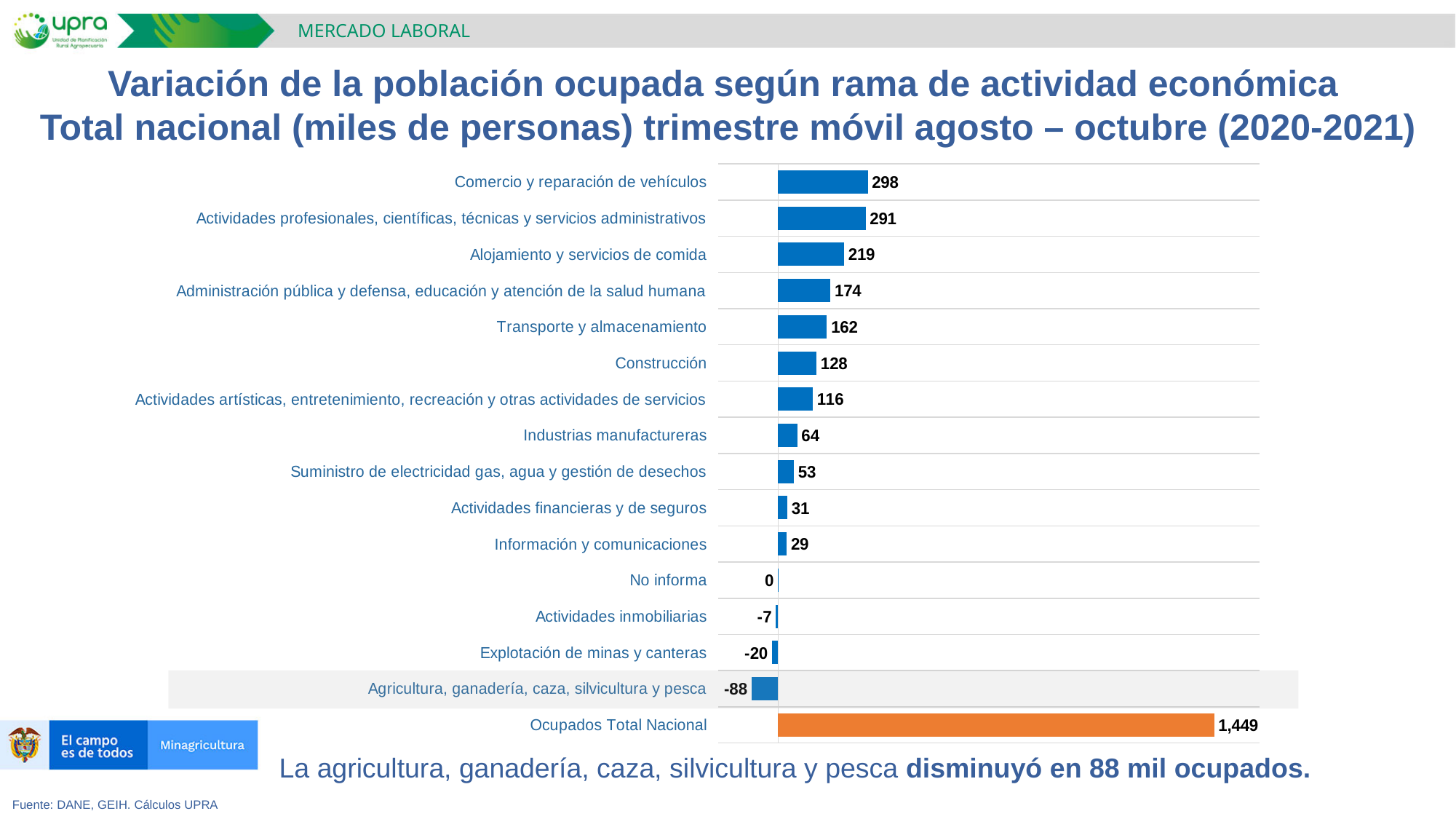
Which category has the lowest value? Agricultura, ganadería, caza, silvicultura y pesca What is the value for Explotación de minas y canteras? -20 What is the difference between the values for Alojamiento y servicios de comida and Administración pública y defensa, educación y atención de la salud humana? 45 What is the value for Ocupados Total Nacional? 1,449 How many bars (categories) are shown in the chart? 16 What is the difference between the values for Comercio y reparación de vehículos and Actividades profesionales, científicas, técnicas y servicios administrativos? 7 Which bar is coloured orange instead of blue? Ocupados Total Nacional What is the value for Agricultura, ganadería, caza, silvicultura y pesca? -88 Which is larger, the value for Construcción or the value for Industrias manufactureras? Construcción What is the value for Comercio y reparación de vehículos? 298 Excluding Ocupados Total Nacional, which category has the highest value? Comercio y reparación de vehículos What kind of chart is shown on the slide? Bar chart